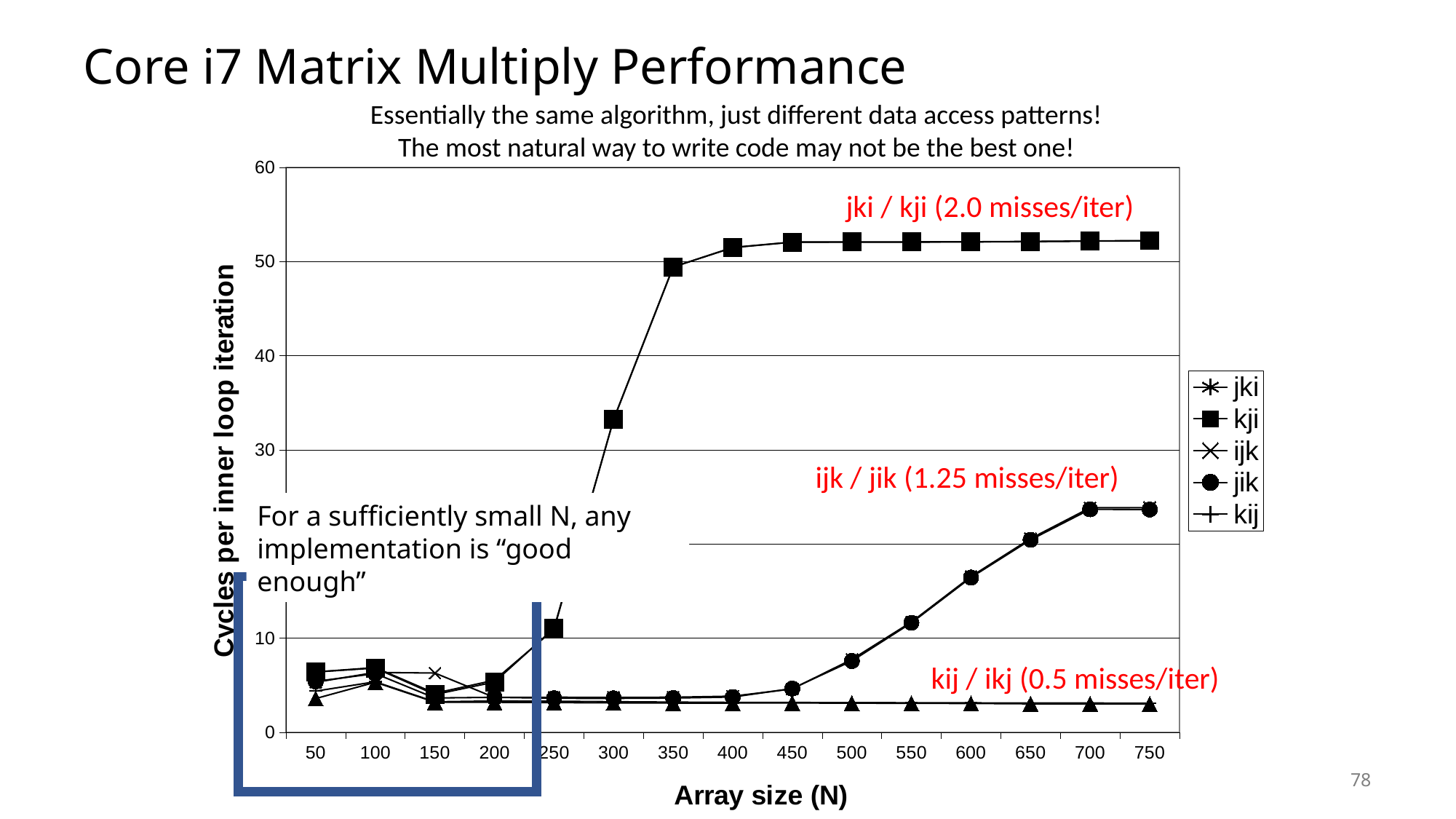
What is the title of the x axis? Array size (N) Does the kji series rise or fall between array sizes 250 and 350? rise Is the value for kji at array size 300 greater or less than 30? greater Is the value for jik at array size 500 greater or less than 10? less How many series does the chart legend list? 5 Is the value for kij at array size 750 greater or less than 10? less At array size 750, which is larger: the value for kji or the value for jik? kji What kind of chart is shown on the slide? line chart How many array size values are marked along the x axis? 15 According to the annotation on the chart, how many misses per iteration do the jki / kji implementations have? 2.0 misses/iter